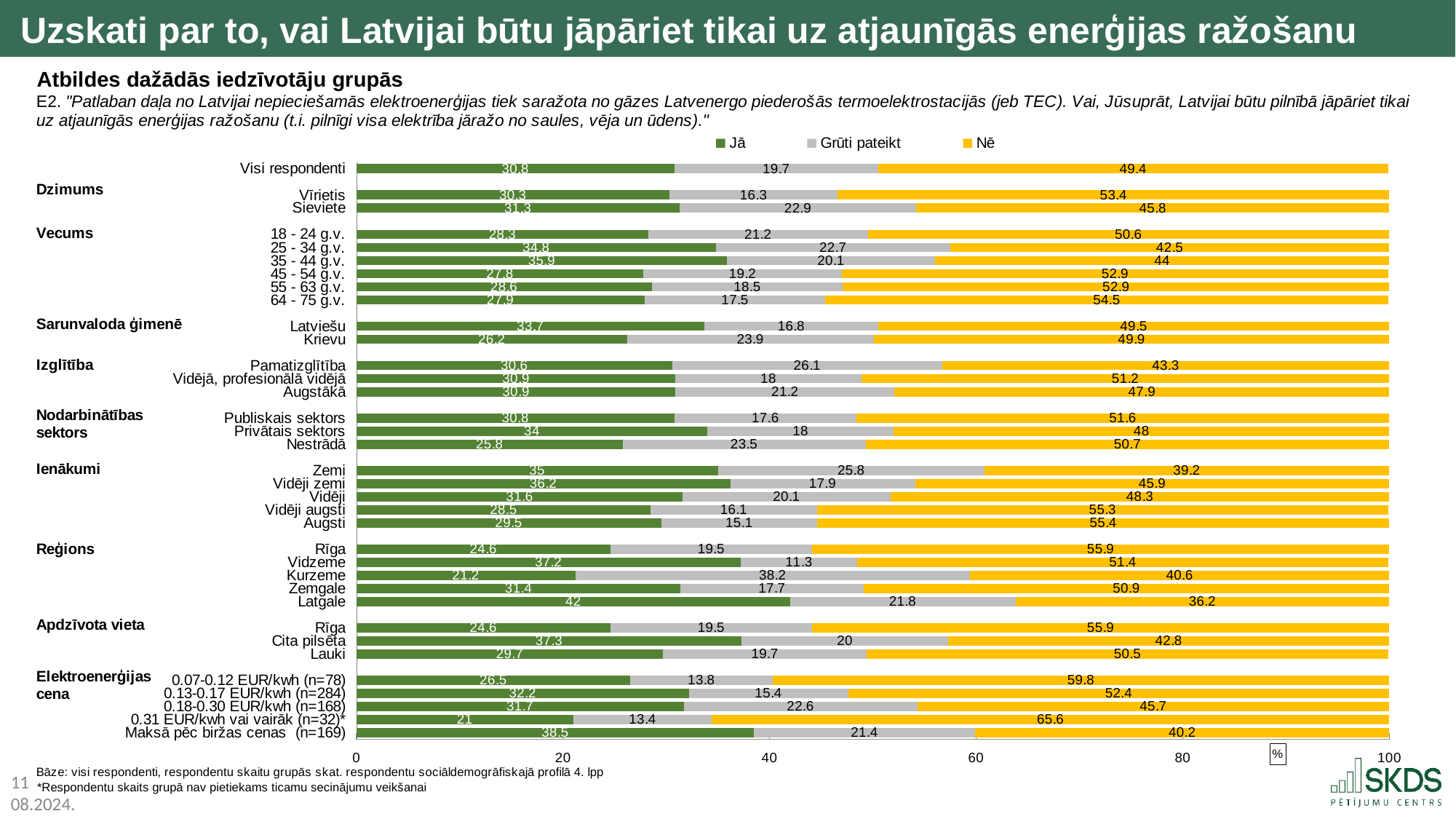
What is the difference between the "Nē" values for "Vīrietis" and "Sieviete"? 7.6 Which has a larger "Jā" value, "Latviešu" or "Krievu"? Latviešu Which group has the lowest "Grūti pateikt" value? Vidzeme How many series does the legend list? 3 What kind of chart is shown on the slide? Stacked bar chart What is the total of the three segments for "Visi respondenti"? 99.9 What is the value of "Grūti pateikt" for "Kurzeme"? 38.2 What is the value of "Nē" for "Latgale"? 36.2 Is the "Nē" value for "Rīga" greater or less than 50? greater Which group has the highest "Nē" value? 0.31 EUR/kwh vai vairāk (n=32)* Which group has the highest "Jā" value? Latgale What is the value of "Jā" for "Visi respondenti"? 30.8